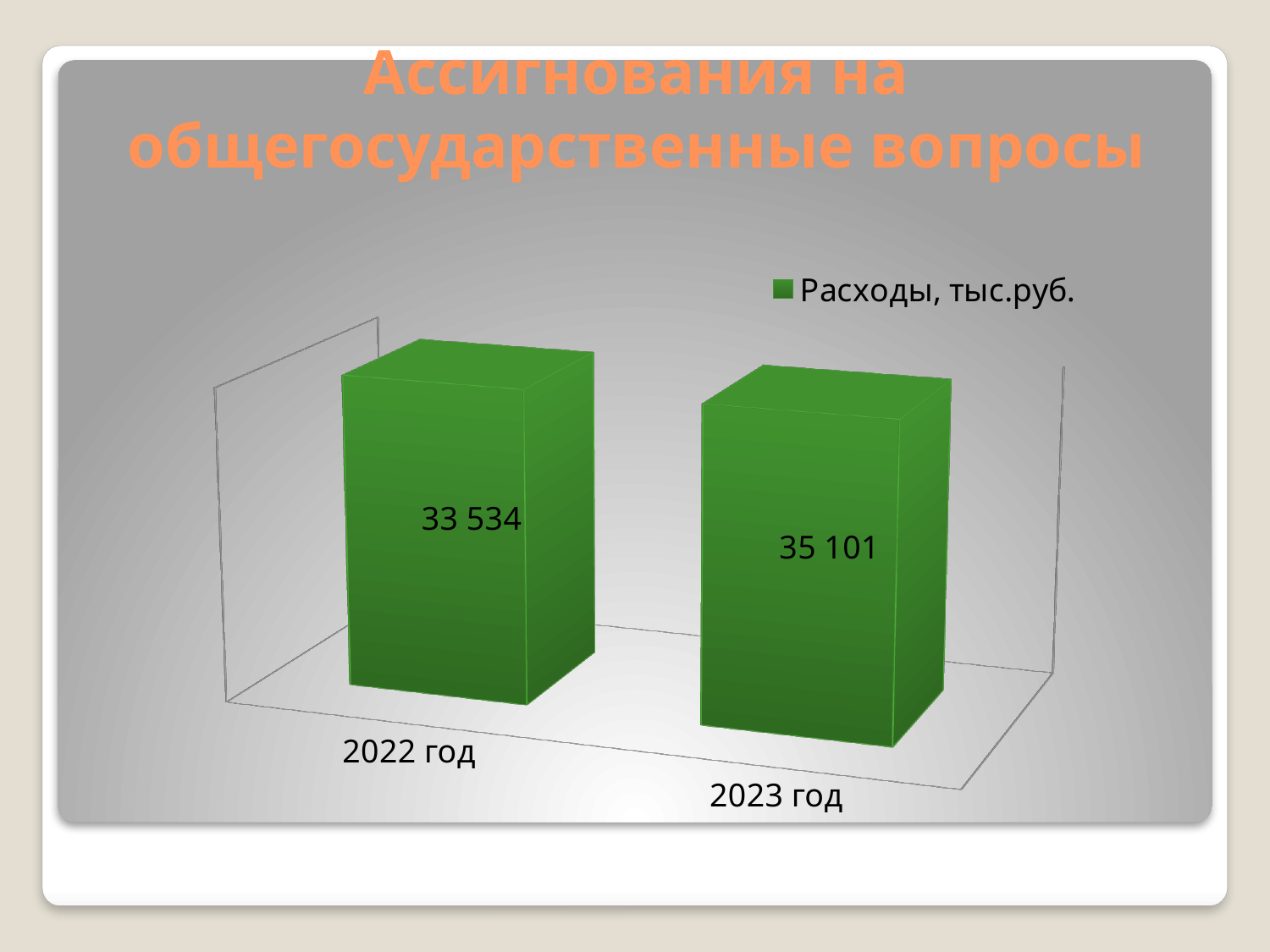
Is the value for 2023 год larger or smaller than the value for 2022 год? larger What is the value for 2022 год? 33 534 What is the difference between the values for 2023 год and 2022 год? 1 567 What is the value for 2023 год? 35 101 How many categories are shown on the x axis? 2 How many series does the legend list? 1 Which year has the lower value? 2022 год What is the legend entry of the series shown? Расходы, тыс.руб. What is the title of the chart? Ассигнования на общегосударственные вопросы Do the values rise or fall from 2022 год to 2023 год? rise Which year has the higher value? 2023 год What kind of chart is shown on the slide? bar chart